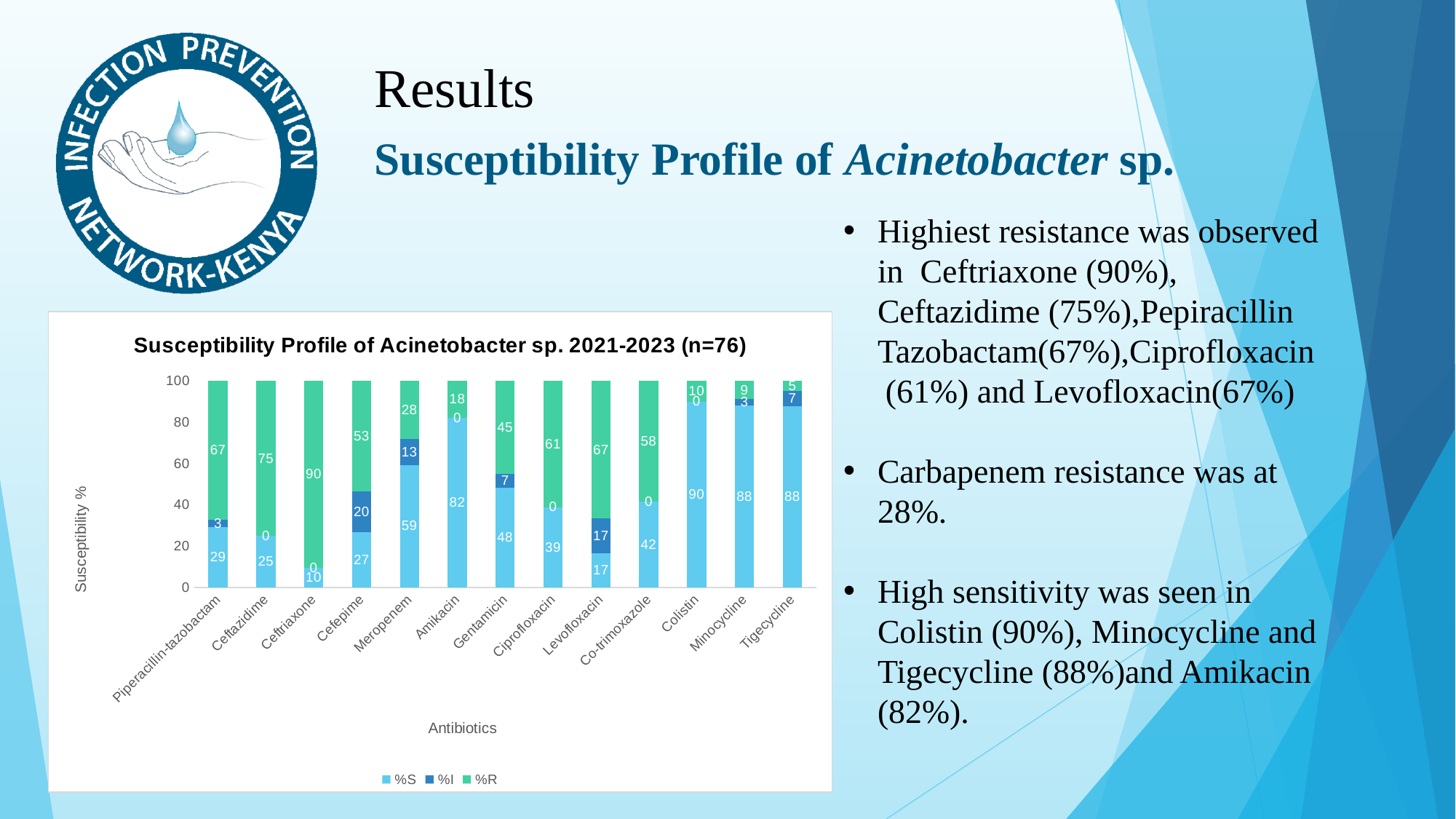
Which antibiotic has the lowest %S value? Ceftriaxone What is the difference between the %S values for Colistin and Amikacin? 8 How many series does the legend list? 3 What is the total of the stacked bar for Cefepime (%S + %I + %R)? 100 Which is larger, the %R value for Ceftazidime or the %R value for Ciprofloxacin? Ceftazidime How many antibiotics are shown on the x axis? 13 What is the title of the chart? Susceptibility Profile of Acinetobacter sp. 2021-2023 (n=76) What is the %R value for Ceftriaxone? 90 What is the %I value for Cefepime? 20 What kind of chart is shown on the slide? Stacked bar chart Which antibiotic has the highest %R value? Ceftriaxone What is the %S value for Meropenem? 59